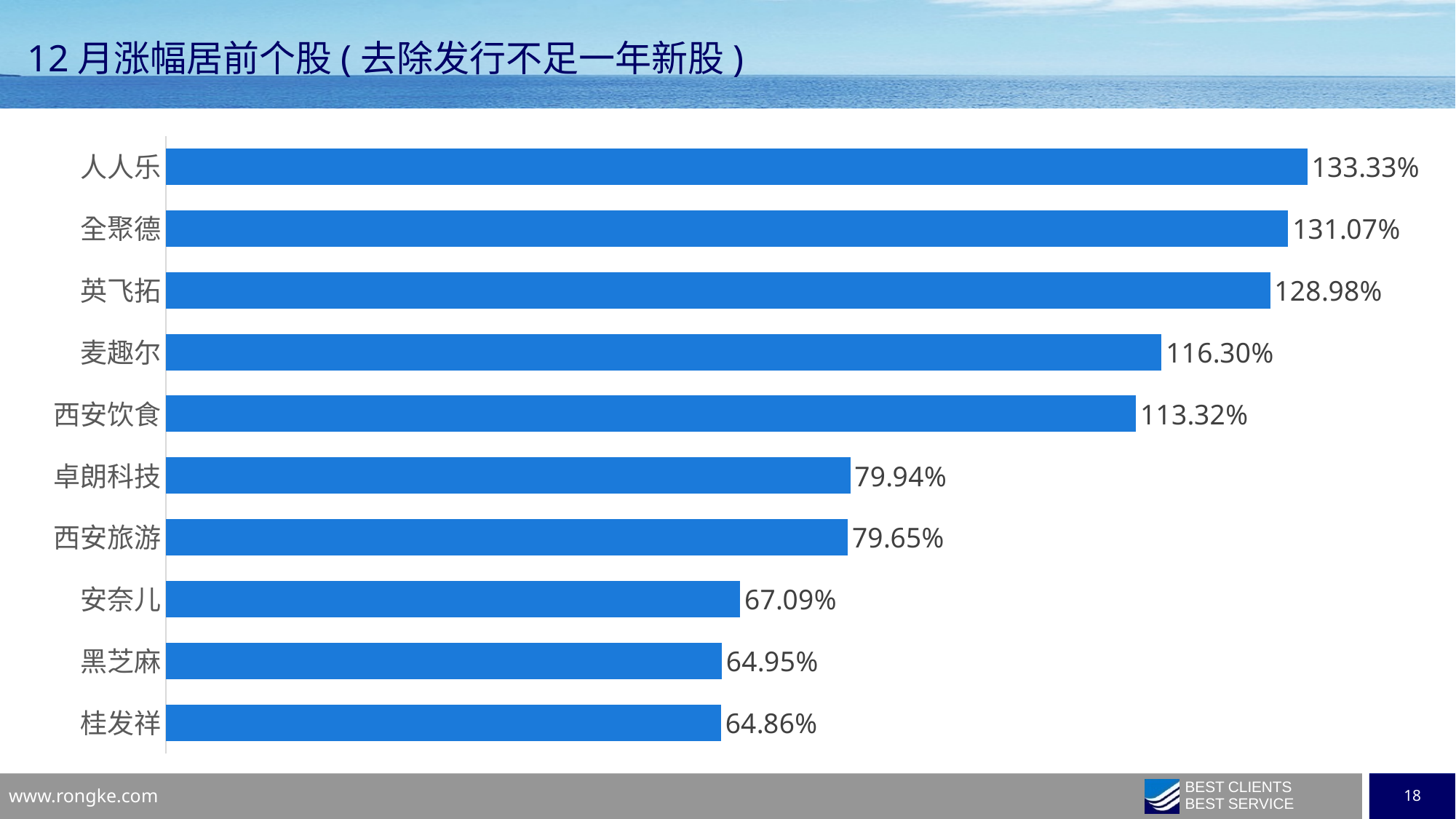
Which is larger, the value for 英飞拓 or the value for 麦趣尔? 英飞拓 How many stocks are shown in the chart? 10 Which stock has the highest value? 人人乐 What is the value for 安奈儿? 67.09% What is the difference between the values for 人人乐 and 全聚德? 2.26% What is the value for 人人乐? 133.33% What kind of chart is this? bar chart Do the values rise or fall from the top bar to the bottom bar? fall What is the difference between the values for 西安饮食 and 卓朗科技? 33.38% Which stock has the lowest value? 桂发祥 What is the value for 麦趣尔? 116.30% What is the title of the chart? 12月涨幅居前个股（去除发行不足一年新股）